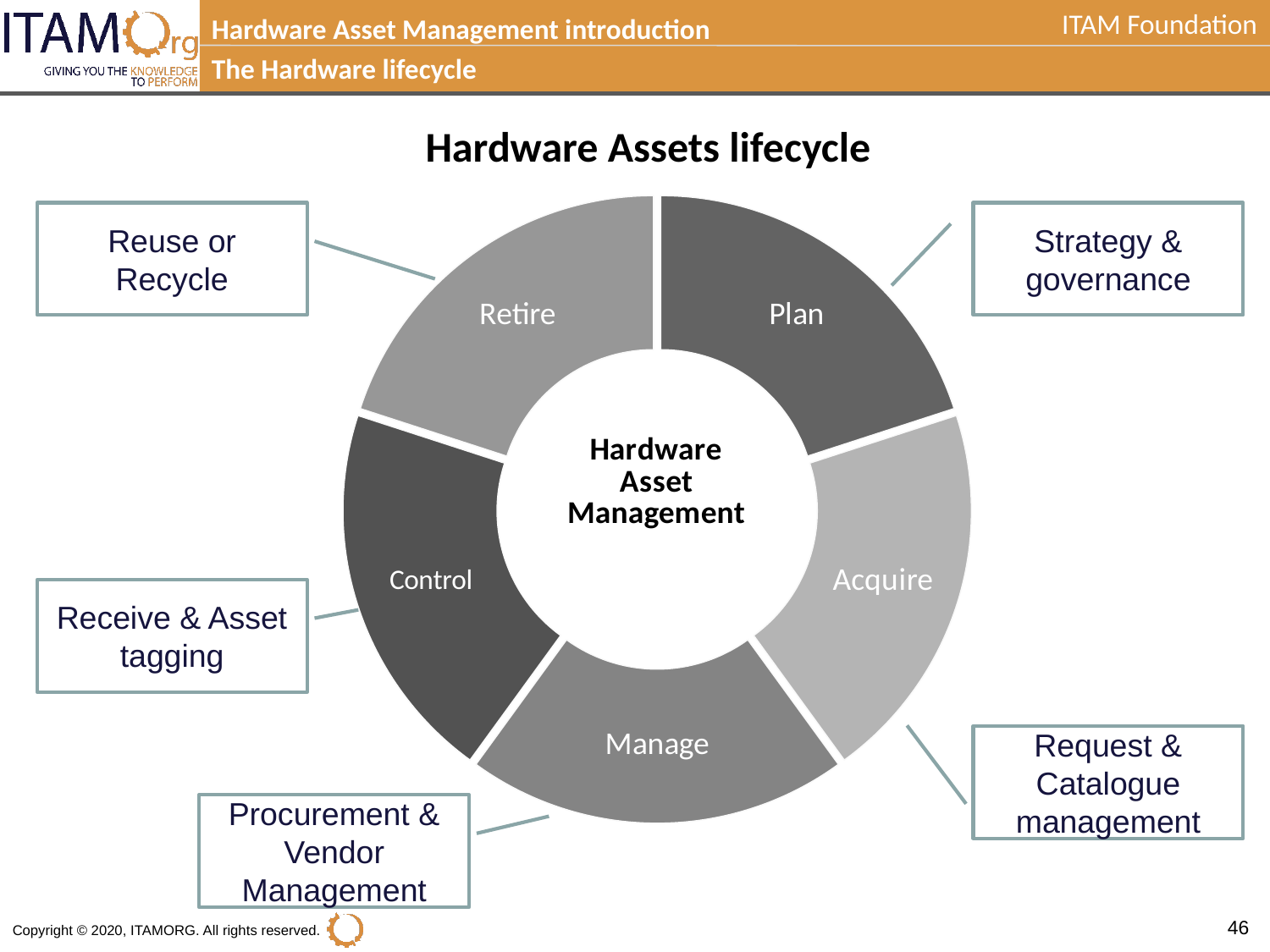
Which segment of the doughnut chart is labelled at the top left? Retire Which segment of the doughnut chart sits between Plan and Manage? Acquire What is the title of the chart? Hardware Assets lifecycle Which segment of the doughnut chart is at the bottom? Manage Which segment of the doughnut chart is labelled at the top right? Plan Which segment of the doughnut chart sits between Manage and Retire? Control What kind of chart is shown on the slide? Doughnut chart How many segments does the doughnut chart have? 5 Which callout box is connected to the Manage segment? Procurement & Vendor Management What text appears in the centre of the doughnut chart? Hardware Asset Management Which callout box is connected to the Retire segment? Reuse or Recycle Which callout box is connected to the Plan segment? Strategy & governance